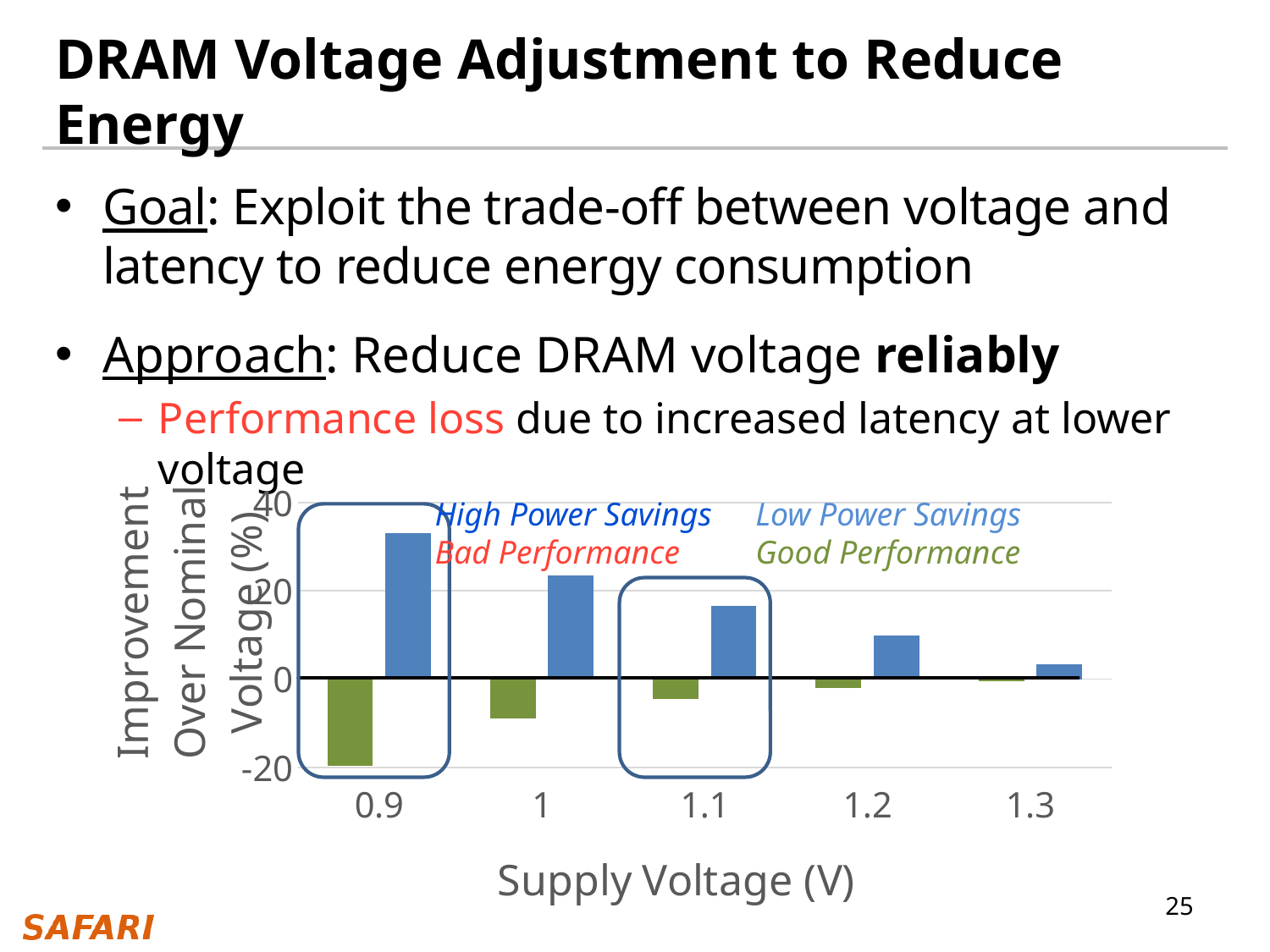
Is the value of the blue bar at 1.3 V greater or less than 20? less How many supply voltage categories are shown on the x axis of the chart? 5 At which supply voltage is the green bar the lowest? 0.9 What is the title of the y axis of the chart? Improvement Over Nominal Voltage (%) Do the blue bars rise or fall as the supply voltage increases from 0.9 V to 1.3 V? fall Is the value of the blue bar at 1.2 V greater or less than 20? less What is the title of the x axis of the chart? Supply Voltage (V) At which supply voltage is the blue bar the highest? 0.9 What kind of chart is shown on the slide? bar chart Is the value of the green bar at 0.9 V greater or less than 0? less Which is larger, the blue bar at 1 V or the blue bar at 1.2 V? the blue bar at 1 V